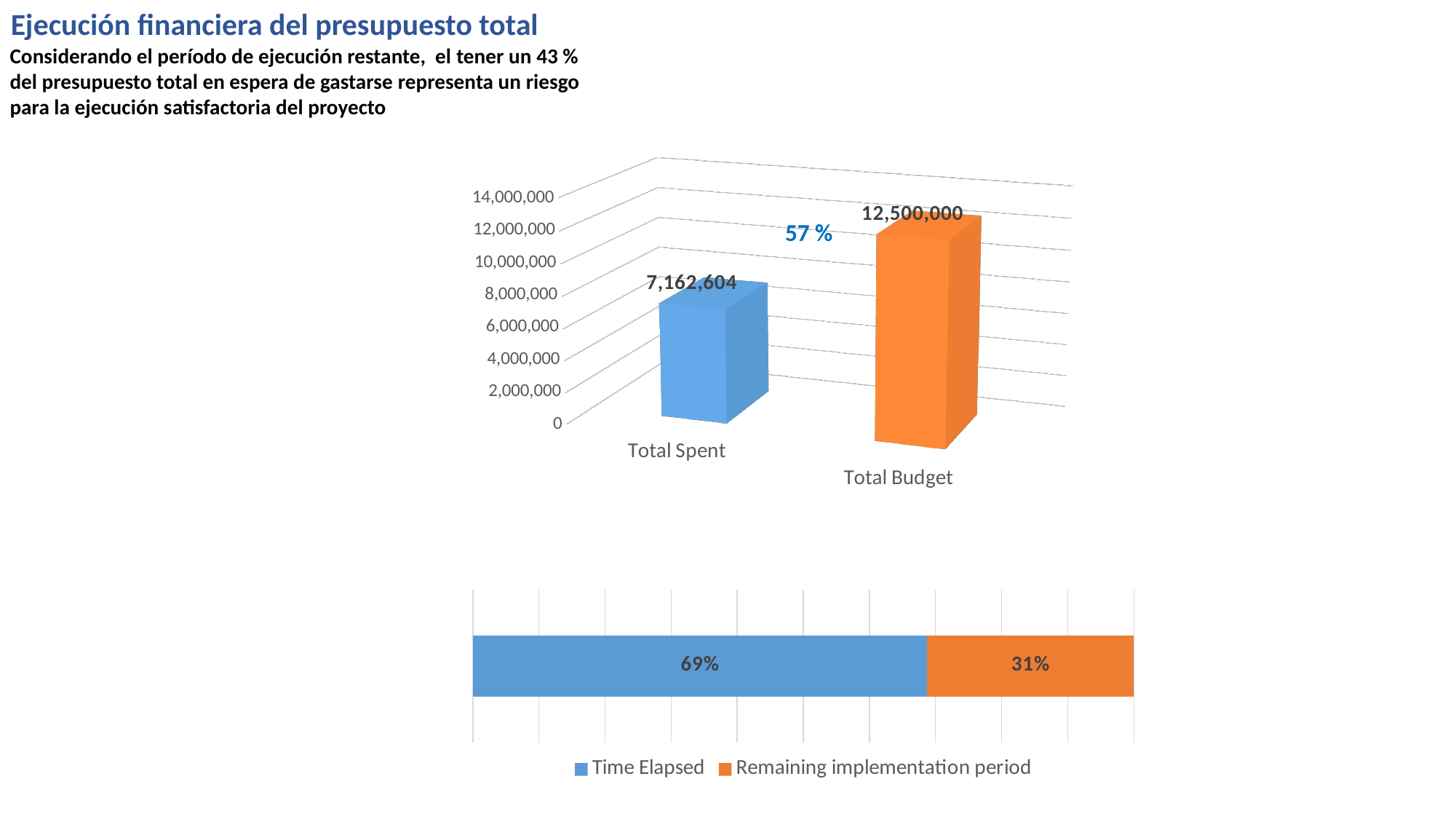
In the top chart, what percentage label is shown between the two bars? 57 % In the top chart, which category has the higher value? Total Budget In the top chart, what is the difference between Total Budget and Total Spent? 5,337,396 In the bottom chart, which is larger, Time Elapsed or Remaining implementation period? Time Elapsed In the bottom chart, how many series does the legend list? 2 In the top chart, what is the value for Total Budget? 12,500,000 In the bottom chart, what is the value for Time Elapsed? 69% In the bottom chart, what is the value for Remaining implementation period? 31% In the top chart, what is the value for Total Spent? 7,162,604 What kind of chart is the top chart? Bar chart In the top chart, how many categories are plotted? 2 In the top chart, which category has the lower value? Total Spent